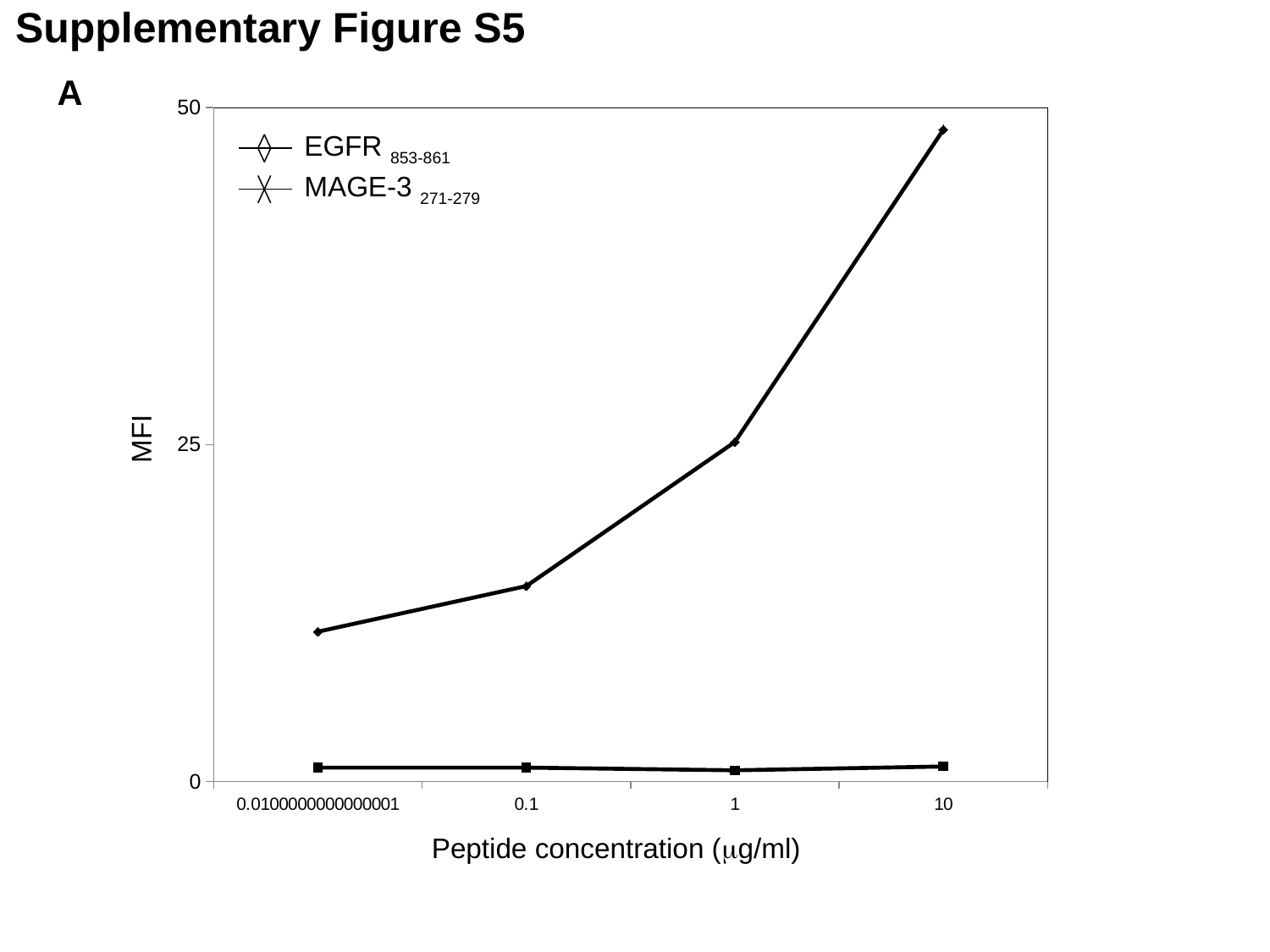
What is the label of the y axis? MFI Is the MFI for EGFR 853-861 at 0.1 µg/ml greater or less than 25? less How many peptide concentrations are plotted along the x axis? 4 At 10 µg/ml, which series has the higher MFI, EGFR 853-861 or MAGE-3 271-279? EGFR 853-861 What kind of chart is shown on the slide? line chart Which series stays close to 0 MFI across all peptide concentrations? MAGE-3 271-279 How many series does the legend list? 2 Does the MFI for EGFR 853-861 rise or fall as peptide concentration increases along the x axis? rise Is the MFI for MAGE-3 271-279 at 10 µg/ml greater or less than 25? less Is the MFI for EGFR 853-861 at 10 µg/ml greater or less than 25? greater What is the label of the x axis? Peptide concentration (µg/ml) At which peptide concentration is the MFI for EGFR 853-861 highest? 10